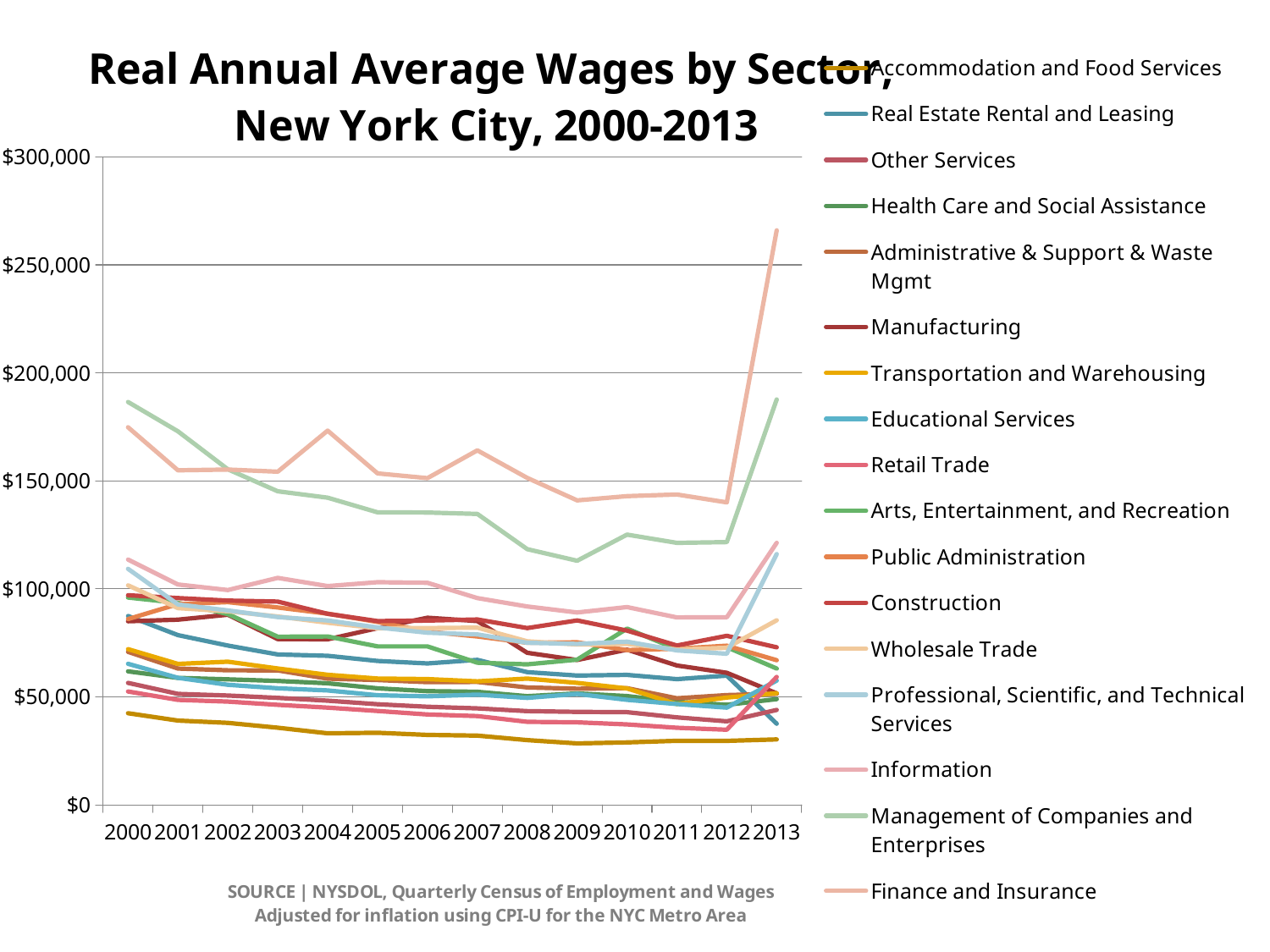
What is the title of the chart? Real Annual Average Wages by Sector, New York City, 2000-2013 Is the value for Accommodation and Food Services in 2013 greater or less than $50,000? less How many years are shown along the x axis? 14 How many series does the legend list? 17 In 2013, which is larger: Finance and Insurance or Management of Companies and Enterprises? Finance and Insurance Which sector has the highest real annual average wage in 2013? Finance and Insurance What kind of chart is shown on the slide? Line chart Does the Finance and Insurance line rise or fall between 2012 and 2013? Rise Is the value for Management of Companies and Enterprises in 2013 greater or less than $150,000? greater Does the Management of Companies and Enterprises line rise or fall between 2000 and 2009? Fall Is the value for Finance and Insurance in 2013 greater or less than $250,000? greater Which sector has the lowest real annual average wage in 2013? Accommodation and Food Services